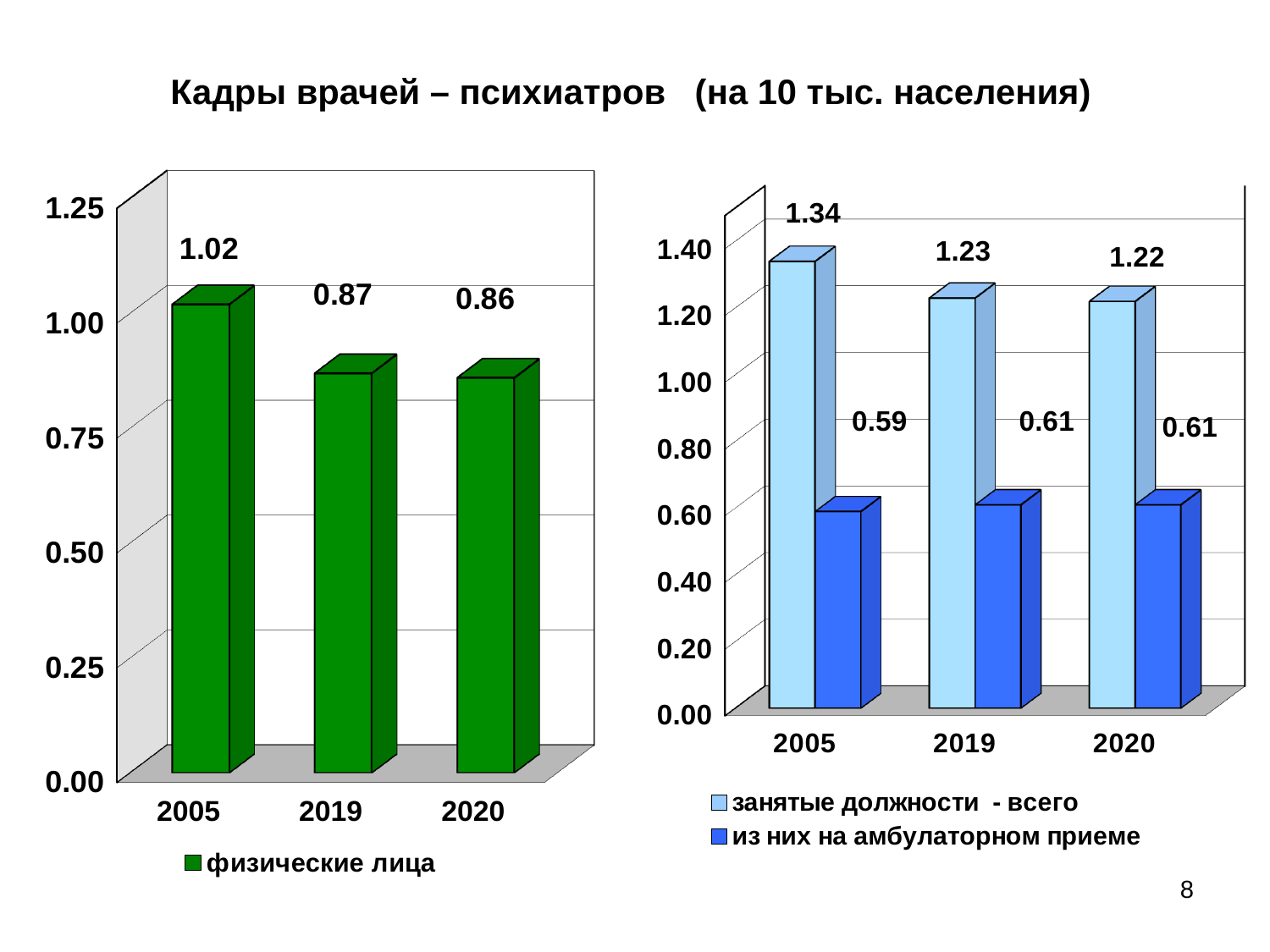
In the right chart, what is the value for занятые должности - всего in 2005? 1.34 What kind of chart is the left chart? bar chart In the right chart, what is the value for из них на амбулаторном приеме in 2019? 0.61 In the left chart, what is the value for физические лица in 2020? 0.86 In the right chart, what is the difference between занятые должности - всего and из них на амбулаторном приеме in 2020? 0.61 In the left chart, what is the value for физические лица in 2005? 1.02 In the left chart, what is the difference between the 2005 and 2019 values? 0.15 In the right chart, which year has the lowest value for занятые должности - всего? 2020 In the left chart, which year has the highest value? 2005 In the left chart, do the values rise or fall from 2005 to 2020? fall In the right chart, how many series does the legend list? 2 In the left chart, how many years are shown on the x axis? 3